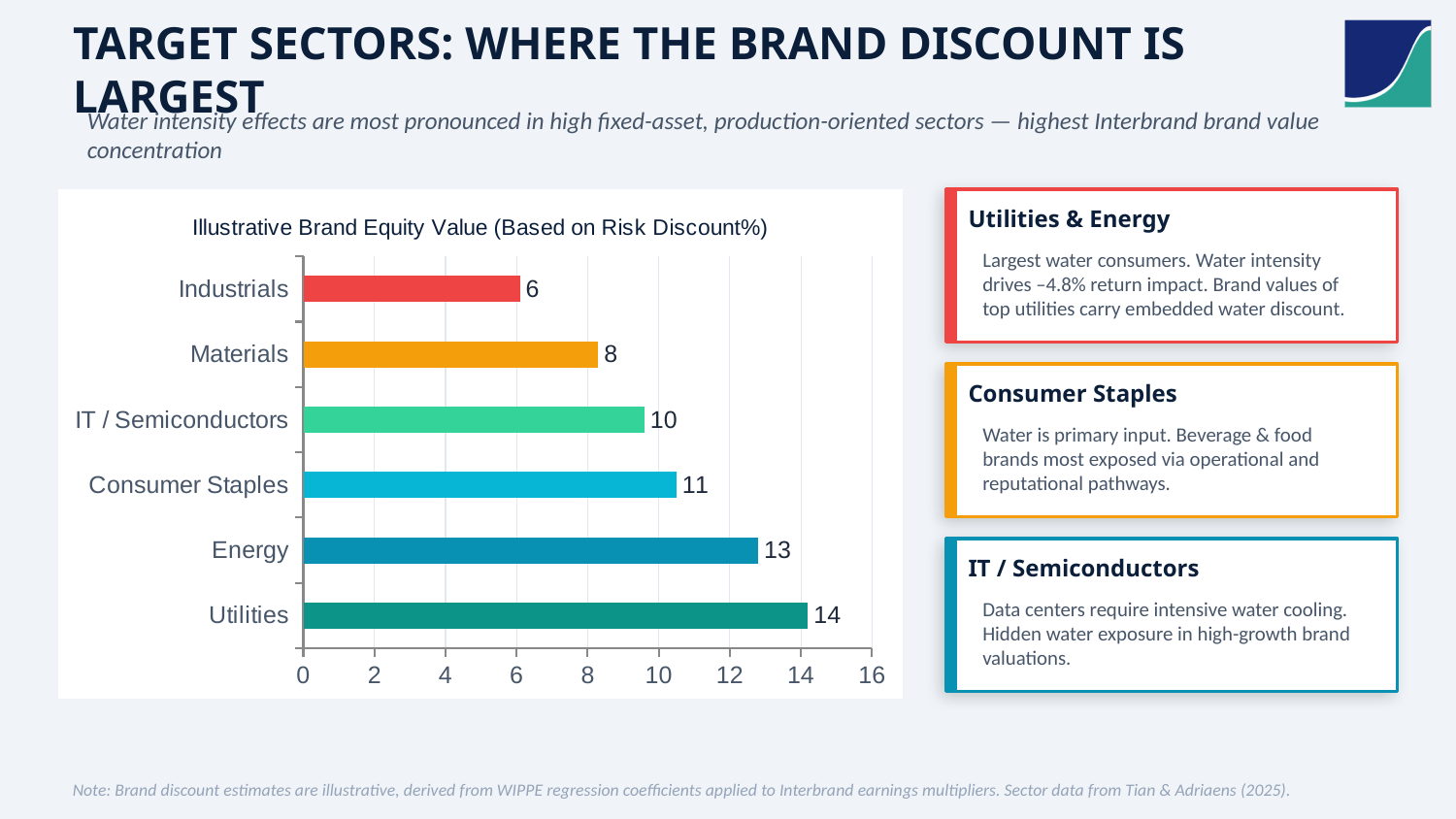
How many categories are shown in the chart? 6 Which category has the lowest value in the chart? Industrials Which category has the highest value in the chart? Utilities What is the value for IT / Semiconductors in the chart? 10 What is the difference between the values for Utilities and Industrials? 8 What is the value for Materials in the chart? 8 What is the title of the chart? Illustrative Brand Equity Value (Based on Risk Discount%) What is the value for Utilities in the chart? 14 Which is larger, the value for Energy or the value for Materials? Energy Is the value for Consumer Staples greater or less than 10? greater What is the difference between the values for Energy and Consumer Staples? 2 What kind of chart is shown on the slide? bar chart